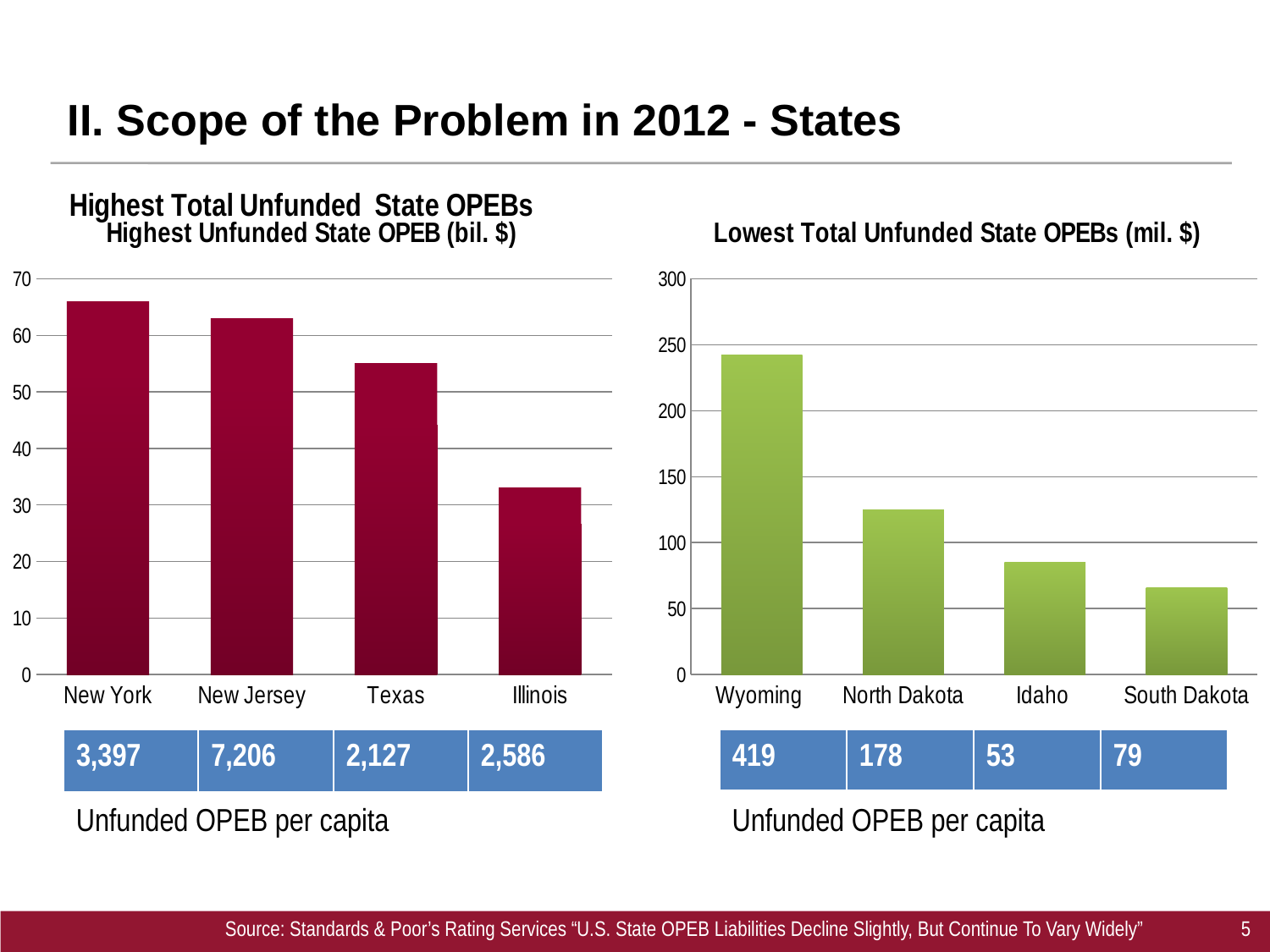
In the right chart, Lowest Total Unfunded State OPEBs (mil. $), do the values rise or fall from Wyoming to South Dakota? Fall In the left chart, Highest Unfunded State OPEB (bil. $), which state has the highest value? New York In the right chart, Lowest Total Unfunded State OPEBs (mil. $), is the value for Wyoming greater or less than 200? greater In the right chart, Lowest Total Unfunded State OPEBs (mil. $), which state has the highest value? Wyoming In the left chart, Highest Unfunded State OPEB (bil. $), which state has the lowest value? Illinois In the left chart, Highest Unfunded State OPEB (bil. $), is the value for Illinois greater or less than 40? less How many states are shown in the left chart, Highest Unfunded State OPEB (bil. $)? 4 In the left chart, Highest Unfunded State OPEB (bil. $), is the value for Texas greater or less than 50? greater In the left chart, Highest Unfunded State OPEB (bil. $), which is larger, the value for New Jersey or the value for Texas? New Jersey What kind of chart is the right chart, Lowest Total Unfunded State OPEBs (mil. $)? Bar chart In the right chart, Lowest Total Unfunded State OPEBs (mil. $), which state has the lowest value? South Dakota